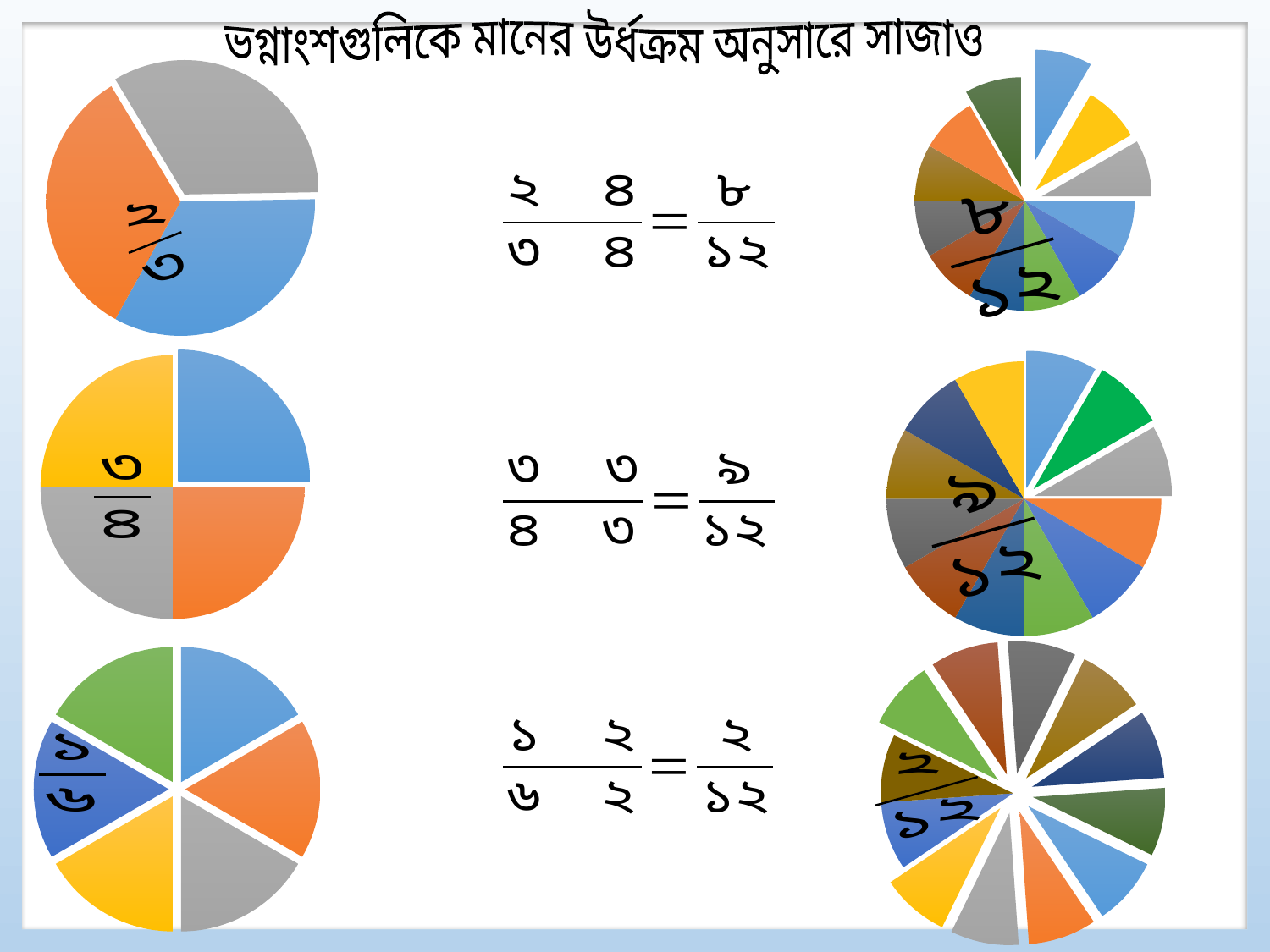
How many pie charts are shown on the slide? 6 How many slices does the middle-left pie chart have? 4 What fraction is written on the top-left pie chart? ২/৩ How many slices does the top-right pie chart have? 12 What kind of chart is the top-left chart on the slide? pie chart What is the title at the top of the slide? ভগ্নাংশগুলিকে মানের ঊর্ধ্বক্রম অনুসারে সাজাও What fraction is written on the bottom-left pie chart? ১/৬ What fraction is written on the middle-right pie chart? ৯/১২ What fraction is written on the middle-left pie chart? ৩/৪